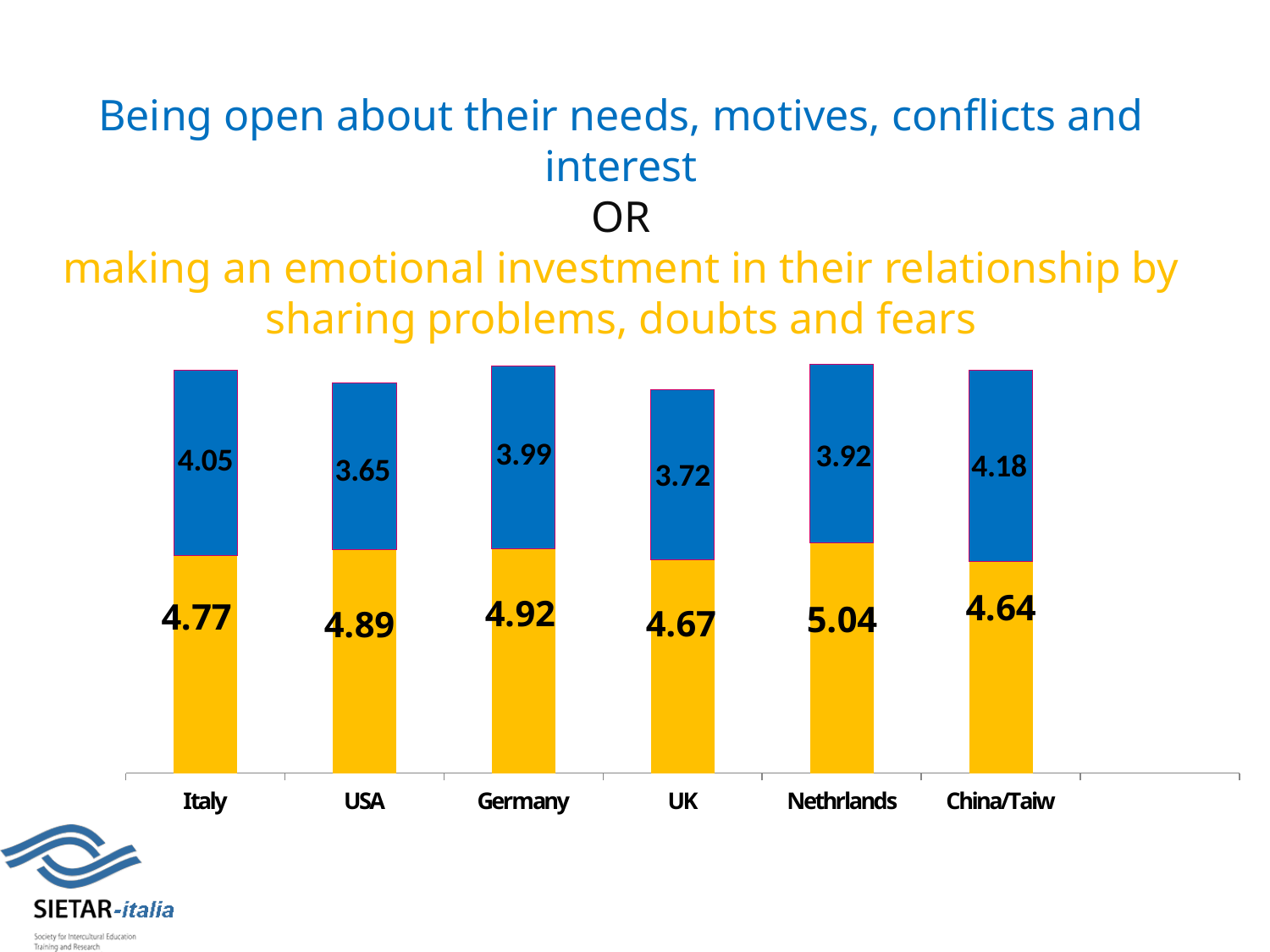
Which is larger, the blue segment for Italy or the blue segment for Germany? Italy What is the difference between the yellow segment values for Germany and the UK? 0.25 Which country has the lowest value in the yellow segment? China/Taiw Which country has the lowest value in the blue segment? USA How many countries are shown on the x axis of the chart? 6 What is the value of the blue segment for the USA? 3.65 What is the value of the blue segment for China/Taiw? 4.18 Which country has the highest value in the yellow segment? Nethrlands What type of chart is shown on the slide? stacked bar chart What is the value of the yellow segment for Italy? 4.77 What is the total of the stacked bar for the UK? 8.39 What is the total of the stacked bar for Nethrlands? 8.96